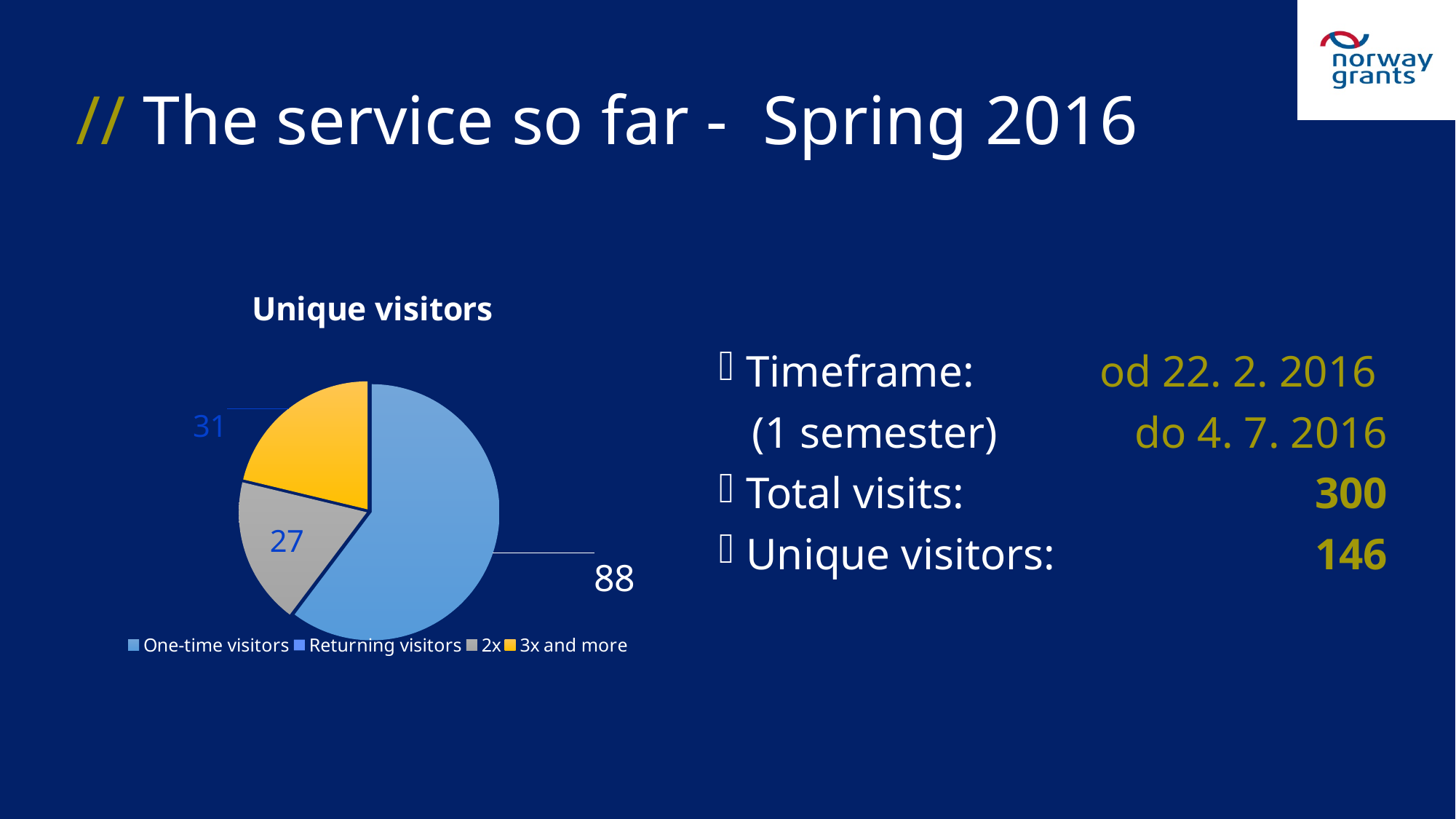
In the Unique visitors pie chart, what is the value for 3x and more? 31 In the Unique visitors pie chart, what is the difference between the 3x and more value and the 2x value? 4 In the Unique visitors pie chart, what is the value for One-time visitors? 88 What is the sum of the three labelled slices in the Unique visitors pie chart? 146 How many entries does the legend of the Unique visitors chart list? 4 Which category has the largest slice in the Unique visitors pie chart? One-time visitors What kind of chart is used to show Unique visitors? Pie chart In the Unique visitors pie chart, what is the value for the 2x slice? 27 In the Unique visitors pie chart, how much larger is the One-time visitors value than the 2x value? 61 What colour is the One-time visitors slice in the pie chart? Blue Which labelled slice is the smallest in the Unique visitors pie chart? 2x In the Unique visitors pie chart, which is larger: 2x or 3x and more? 3x and more